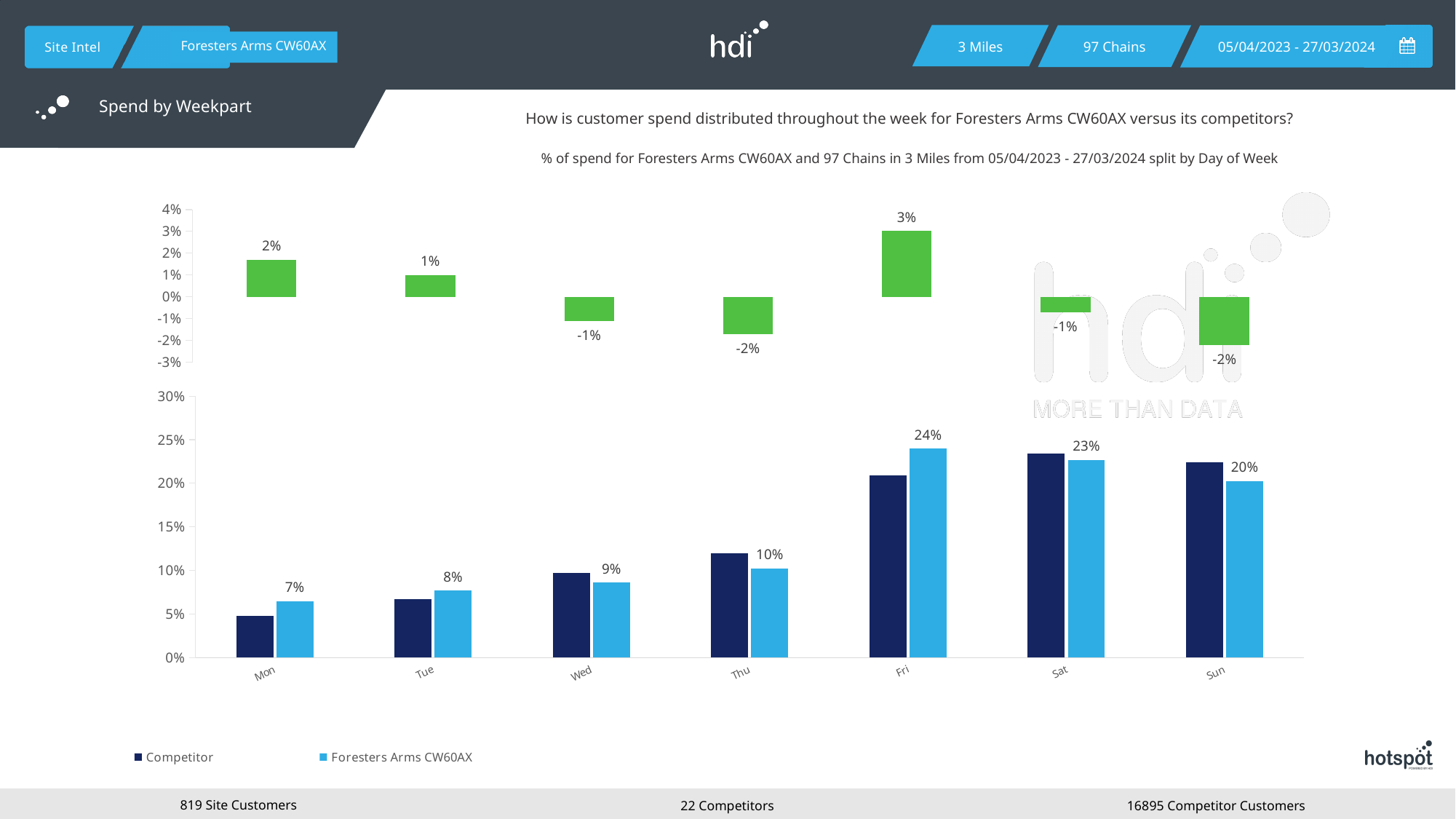
What type of chart is the bottom chart? Bar chart In the bottom chart, is the Competitor value for Fri greater or less than 25%? less In the bottom chart, what is the value for Foresters Arms CW60AX on Mon? 7% In the bottom chart, is the Competitor value for Thu greater or less than 10%? greater In the top chart, what is the value shown for Thu? -2% How many series does the legend of the bottom chart list? 2 In the top chart, which day has the highest value? Fri In the bottom chart, which day has the lowest value for Foresters Arms CW60AX? Mon How many days of the week are shown on the x axis of the bottom chart? 7 In the bottom chart, what is the difference between the Foresters Arms CW60AX values for Fri and Sun? 4% In the bottom chart, what is the value for Foresters Arms CW60AX on Fri? 24% In the bottom chart, on Fri, which series has the larger value: Competitor or Foresters Arms CW60AX? Foresters Arms CW60AX